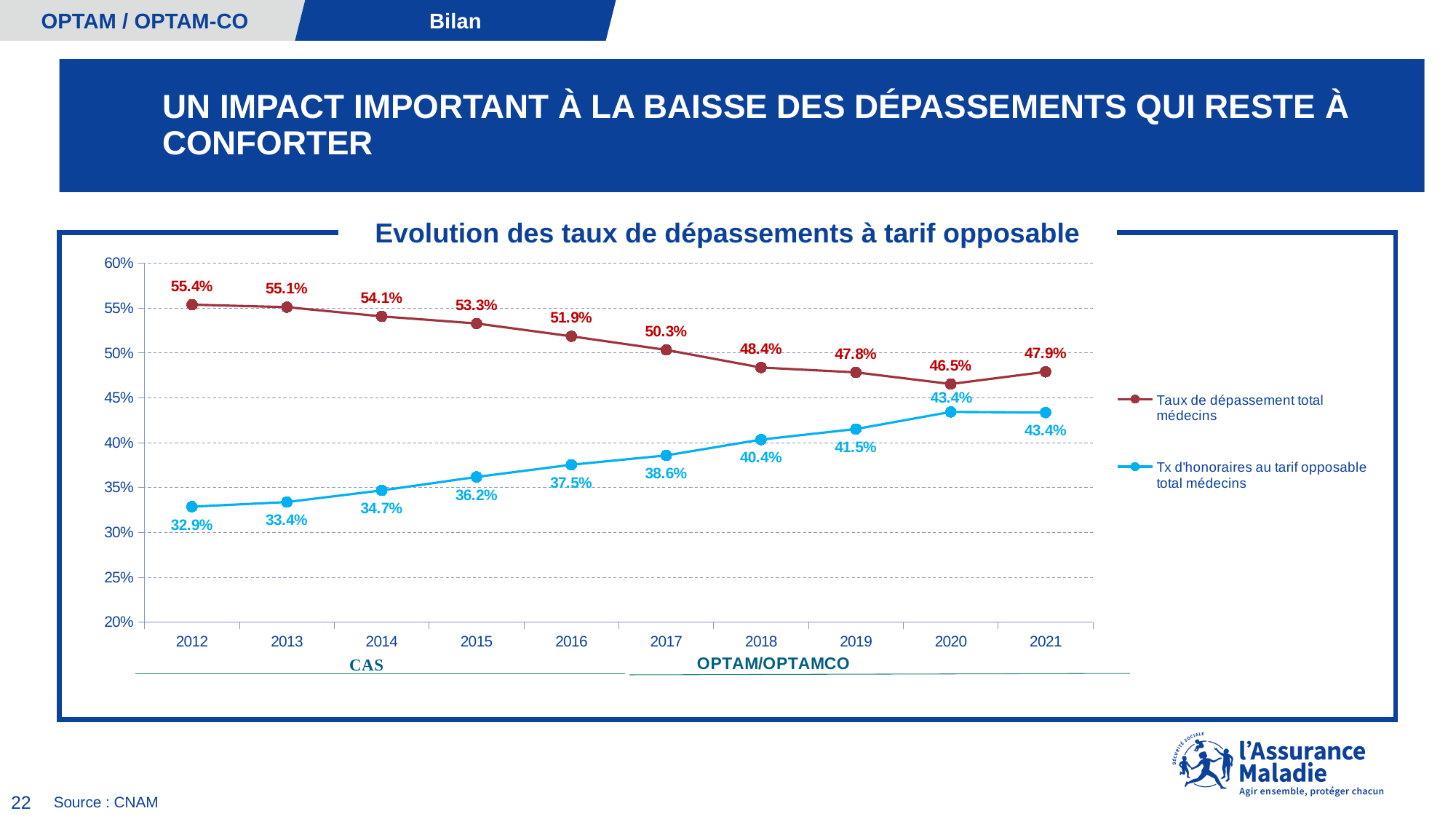
What is the value of 'Taux de dépassement total médecins' in 2020? 46.5% What is the value of 'Tx d'honoraires au tarif opposable total médecins' in 2017? 38.6% Which series has the higher value in 2018: 'Taux de dépassement total médecins' or 'Tx d'honoraires au tarif opposable total médecins'? Taux de dépassement total médecins In which year is 'Taux de dépassement total médecins' at its lowest? 2020 Does 'Tx d'honoraires au tarif opposable total médecins' generally rise or fall from 2012 to 2021? rise How many years are shown on the x axis? 10 How many series does the legend list? 2 What is the title of the chart? Evolution des taux de dépassements à tarif opposable What is the difference between 'Taux de dépassement total médecins' in 2012 and in 2021? 7.5 percentage points What kind of chart is shown on the slide? line chart In which year is 'Tx d'honoraires au tarif opposable total médecins' at its lowest? 2012 What is the value of 'Taux de dépassement total médecins' in 2012? 55.4%